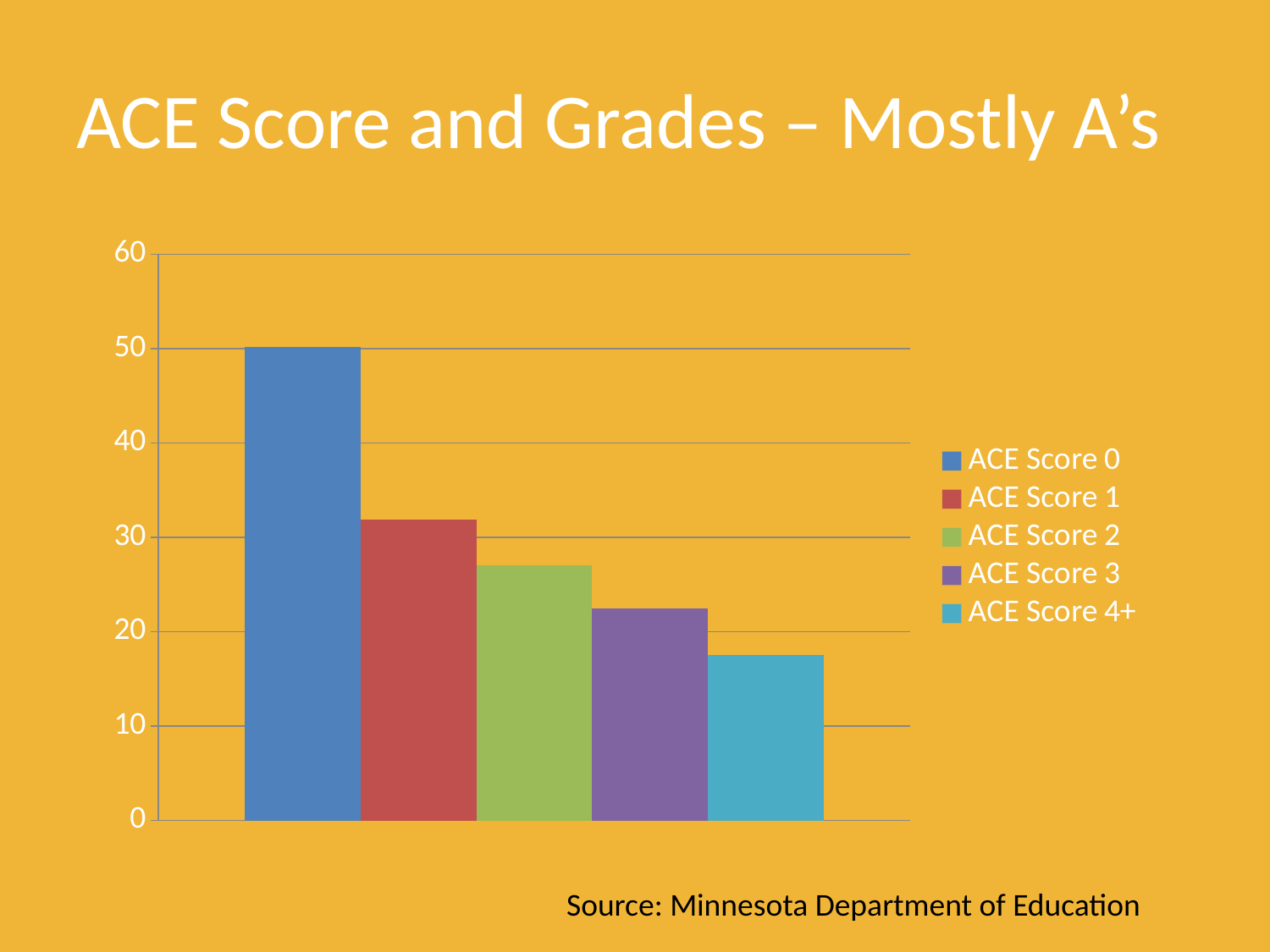
Is the value for ACE Score 2 greater or less than 30? less Is the value for ACE Score 1 greater or less than 30? greater How many series does the legend list? 5 What is the title of the slide containing the chart? ACE Score and Grades – Mostly A's Which ACE score group has the highest bar? ACE Score 0 Is the value for ACE Score 4+ greater or less than 20? less How many bars are plotted in the chart? 5 Which ACE score group has the lowest bar? ACE Score 4+ What kind of chart is shown on the slide? bar chart Which is larger, the value for ACE Score 1 or the value for ACE Score 3? ACE Score 1 Do the bar values rise or fall as the ACE score increases from 0 to 4+? fall